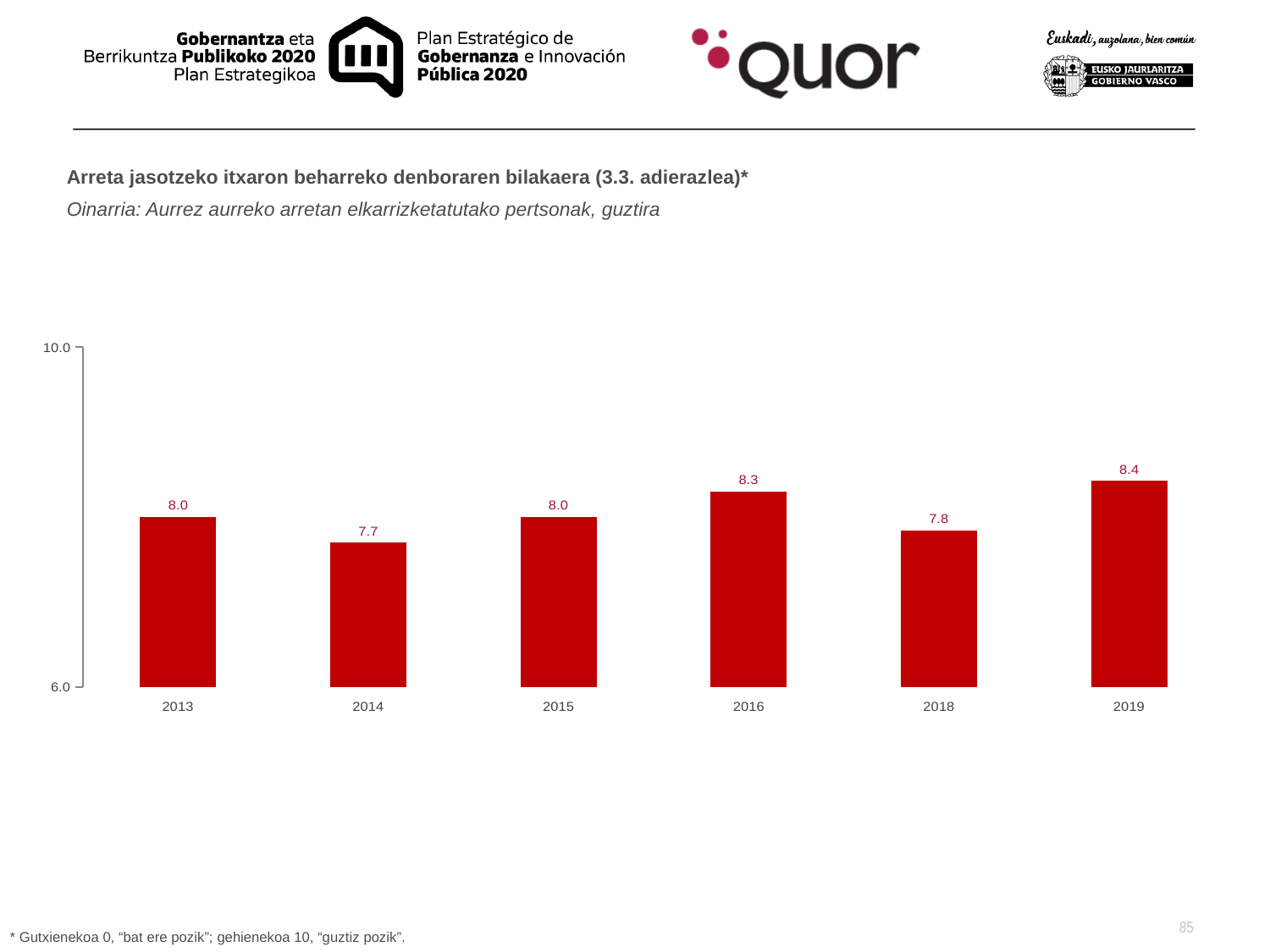
Did the value rise or fall from 2018 to 2019? rise Which year has the lowest value? 2014 How many years are shown on the x axis? 6 What is the value for 2014? 7.7 What is the value for 2016? 8.3 What is the value for 2018? 7.8 Which is larger, the value for 2016 or the value for 2018? 2016 What is the value for 2013? 8.0 Which year has the highest value? 2019 What kind of chart is shown on the slide? bar chart What is the difference between the values for 2019 and 2014? 0.7 What colour are the bars in the chart? red